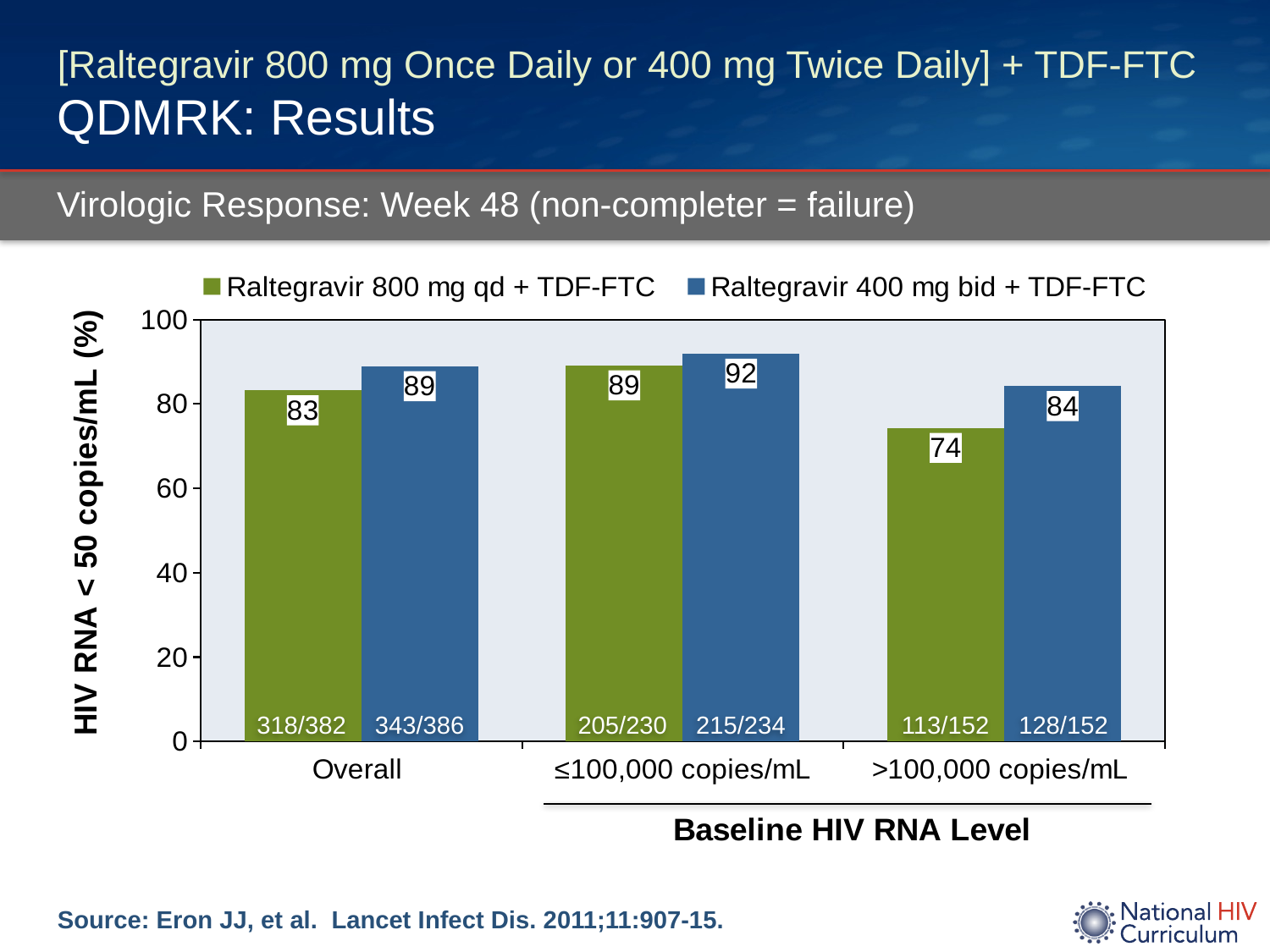
In the Overall category, which series has the larger value? Raltegravir 400 mg bid + TDF-FTC How many categories are shown on the x axis? 3 What is the value for Raltegravir 400 mg bid + TDF-FTC in the ≤100,000 copies/mL category? 92 What is the difference between the Raltegravir 400 mg bid + TDF-FTC and Raltegravir 800 mg qd + TDF-FTC values in the Overall category? 6 Which category has the lowest value for Raltegravir 800 mg qd + TDF-FTC? >100,000 copies/mL What kind of chart is shown on the slide? Bar chart How many series does the legend list? 2 Which category has the highest value for Raltegravir 400 mg bid + TDF-FTC? ≤100,000 copies/mL What is the difference between the Raltegravir 400 mg bid + TDF-FTC and Raltegravir 800 mg qd + TDF-FTC values in the >100,000 copies/mL category? 10 What fraction is printed at the base of the Raltegravir 800 mg qd + TDF-FTC bar in the Overall category? 318/382 What is the value for Raltegravir 400 mg bid + TDF-FTC in the >100,000 copies/mL category? 84 What is the value for Raltegravir 800 mg qd + TDF-FTC in the Overall category? 83